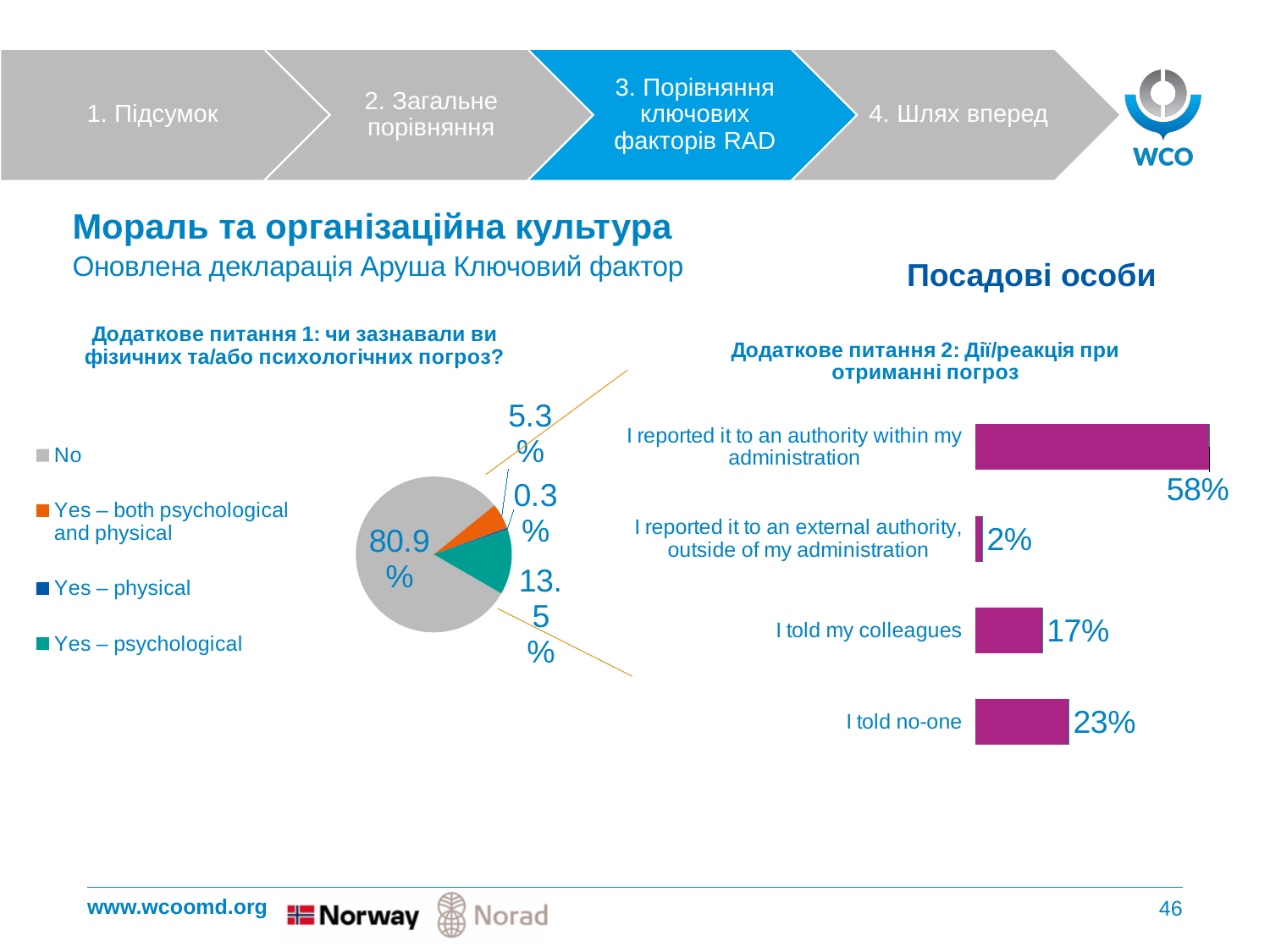
In the pie chart 'Додаткове питання 1', what share of the pie is the 'No' slice? 80.9% In the bar chart 'Додаткове питання 2: Дії/реакція при отриманні погроз', which category has the lowest value? I reported it to an external authority, outside of my administration In the pie chart 'Додаткове питання 1', what is the value for 'Yes – psychological'? 13.5% In the pie chart 'Додаткове питання 1', which is larger: 'Yes – psychological' or 'Yes – both psychological and physical'? Yes – psychological In the bar chart 'Додаткове питання 2: Дії/реакція при отриманні погроз', how many categories are shown? 4 In the bar chart 'Додаткове питання 2: Дії/реакція при отриманні погроз', what is the value for 'I told no-one'? 23% How many entries does the legend of the pie chart 'Додаткове питання 1' list? 4 In the bar chart 'Додаткове питання 2: Дії/реакція при отриманні погроз', what is the value for 'I told my colleagues'? 17% In the bar chart 'Додаткове питання 2: Дії/реакція при отриманні погроз', what is the value for 'I reported it to an authority within my administration'? 58% In the bar chart 'Додаткове питання 2: Дії/реакція при отриманні погроз', what is the difference between 'I told no-one' and 'I told my colleagues'? 6% What kind of chart is the chart titled 'Додаткове питання 2: Дії/реакція при отриманні погроз'? bar chart In the bar chart 'Додаткове питання 2: Дії/реакція при отриманні погроз', which category has the highest value? I reported it to an authority within my administration